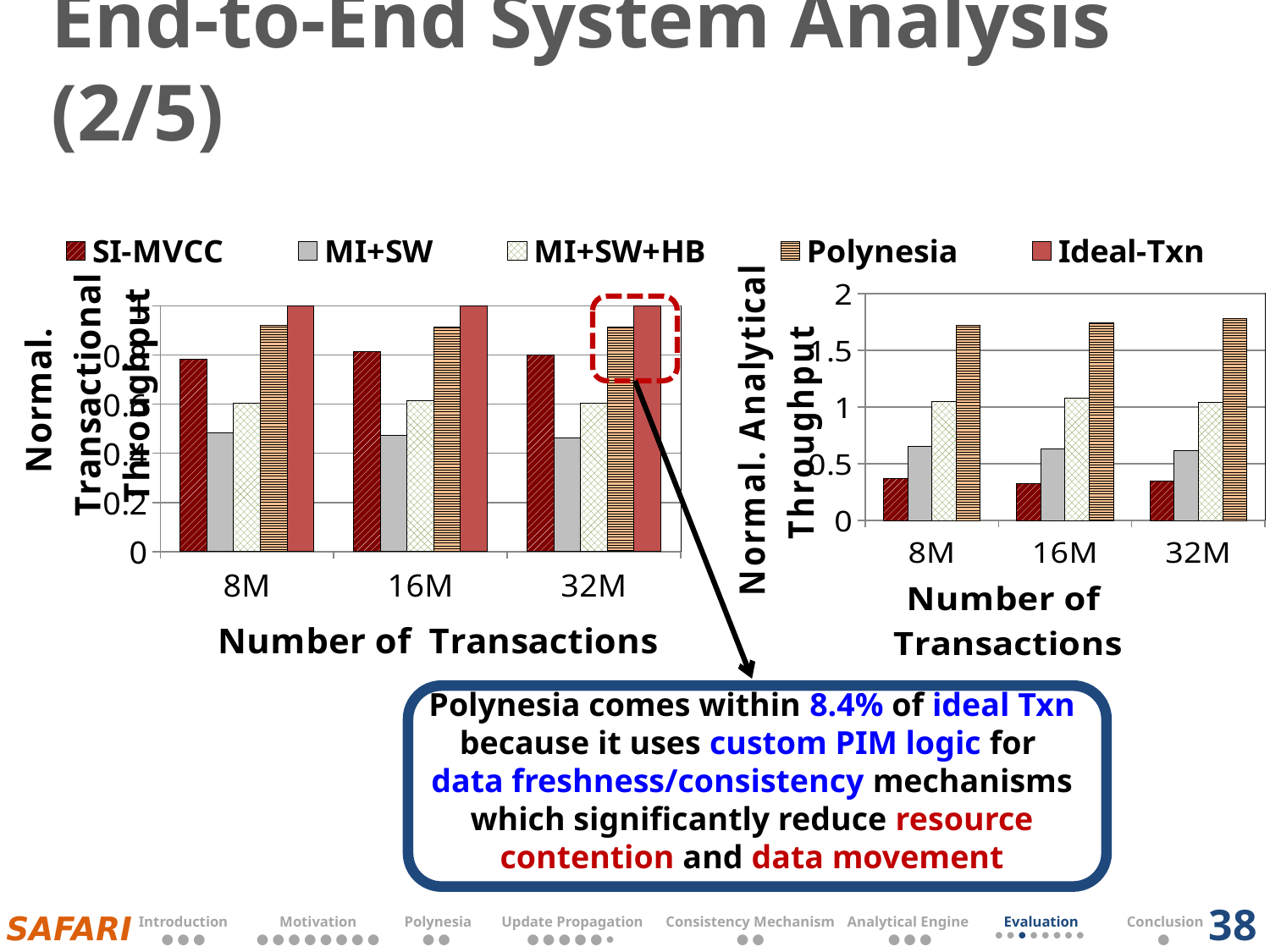
In the left chart (Normal. Transactional Throughput), which series has the highest bar in the 32M group? Ideal-Txn In the left chart (Normal. Transactional Throughput), which is larger at 16M: SI-MVCC or MI+SW? SI-MVCC In the right chart (Normal. Analytical Throughput), which is larger at 8M: MI+SW or MI+SW+HB? MI+SW+HB What kind of chart is the left chart (Normal. Transactional Throughput)? bar chart In the right chart (Normal. Analytical Throughput), is the value for SI-MVCC at 16M greater or less than 0.5? less What is the x-axis title of the left chart? Number of Transactions In the left chart (Normal. Transactional Throughput), which series has the lowest bar in the 8M group? MI+SW In the right chart (Normal. Analytical Throughput), which series has the highest bar in the 16M group? Polynesia How many series does the legend at the top of the slide list? 5 In the right chart (Normal. Analytical Throughput), is the value for Polynesia at 8M greater or less than 1.5? greater How many categories are shown on the x axis of the right chart (Normal. Analytical Throughput)? 3 In the right chart (Normal. Analytical Throughput), which series has the lowest bar in the 32M group? SI-MVCC